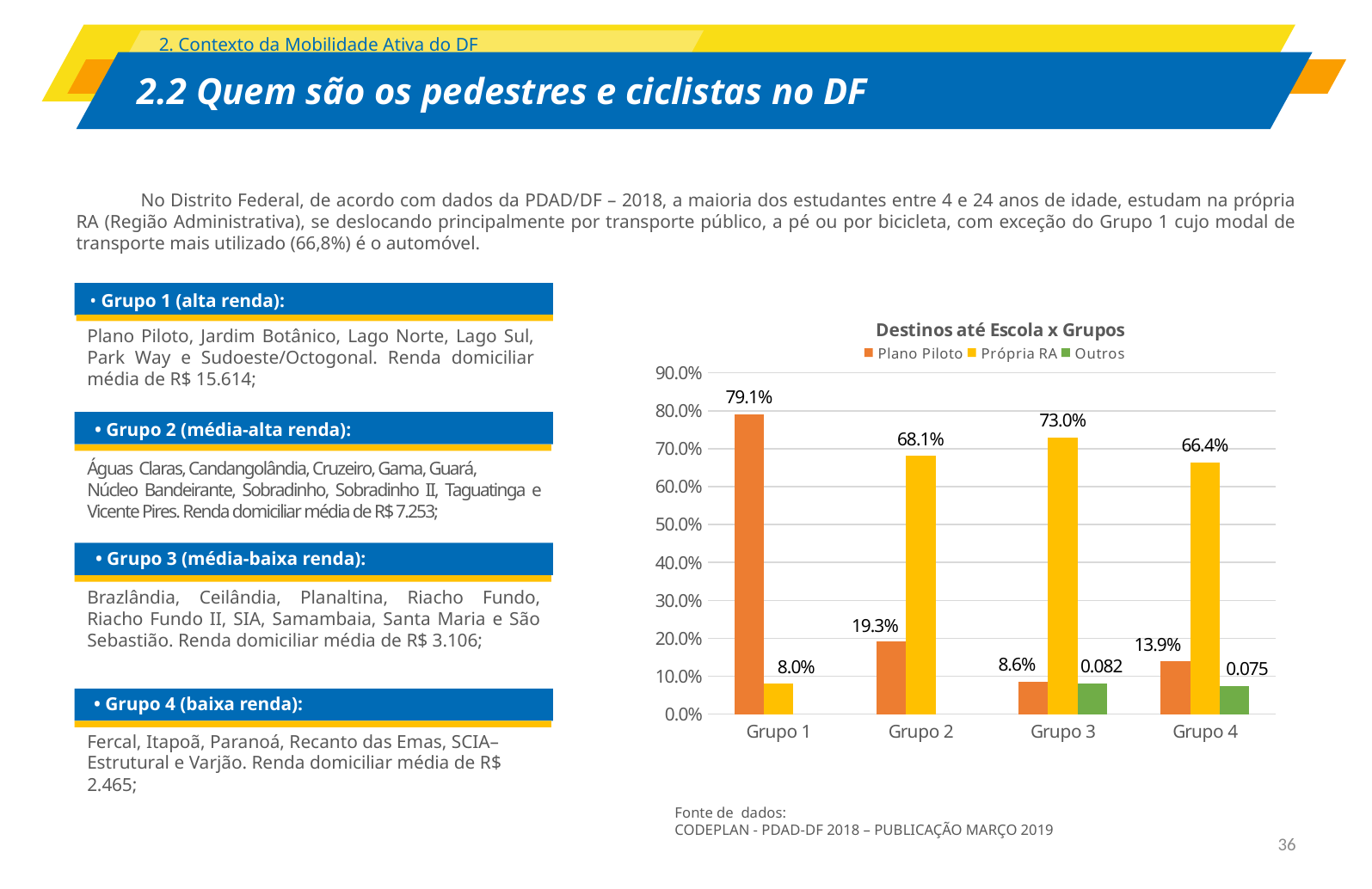
What is the difference between the Plano Piloto values for Grupo 1 and Grupo 2? 59.8% What data label is shown for Outros in Grupo 3? 0.082 Which group has the highest value for Própria RA? Grupo 3 Which is larger: Própria RA in Grupo 2 or Própria RA in Grupo 4? Grupo 2 Is the value for Própria RA in Grupo 1 greater or less than 10.0%? less What type of chart is shown? bar chart What is the value for Plano Piloto in Grupo 1? 79.1% What is the value for Plano Piloto in Grupo 4? 13.9% Which group has the lowest value for Plano Piloto? Grupo 3 How many series does the legend list? 3 What is the value for Própria RA in Grupo 3? 73.0% How many groups are shown on the x axis? 4